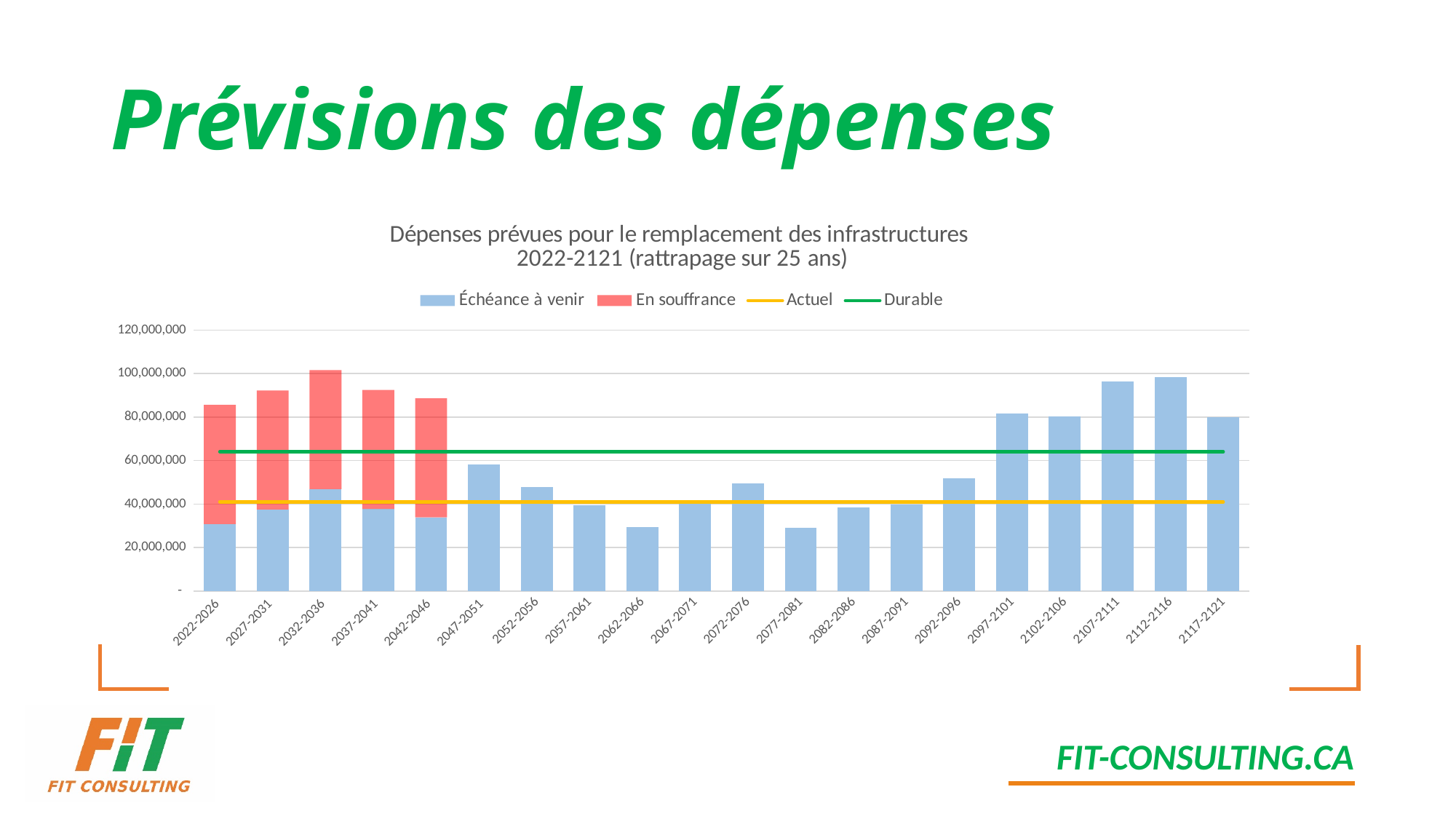
Is the 'Durable' line greater or less than 60,000,000? greater How many five-year periods are shown on the x axis? 20 What is the title of the chart? Dépenses prévues pour le remplacement des infrastructures 2022-2121 (rattrapage sur 25 ans) Is the value for 2092-2096 greater or less than 40,000,000? greater What kind of chart is shown on the slide? Stacked bar chart with line series Which is larger, the value for 2047-2051 or the value for 2052-2056? 2047-2051 Is the value for 2062-2066 greater or less than 40,000,000? less Which series is shown in red? En souffrance How many periods include an 'En souffrance' (red) segment? 5 How many series does the legend list? 4 Do the bar values rise or fall from 2097-2101 to 2112-2116? rise